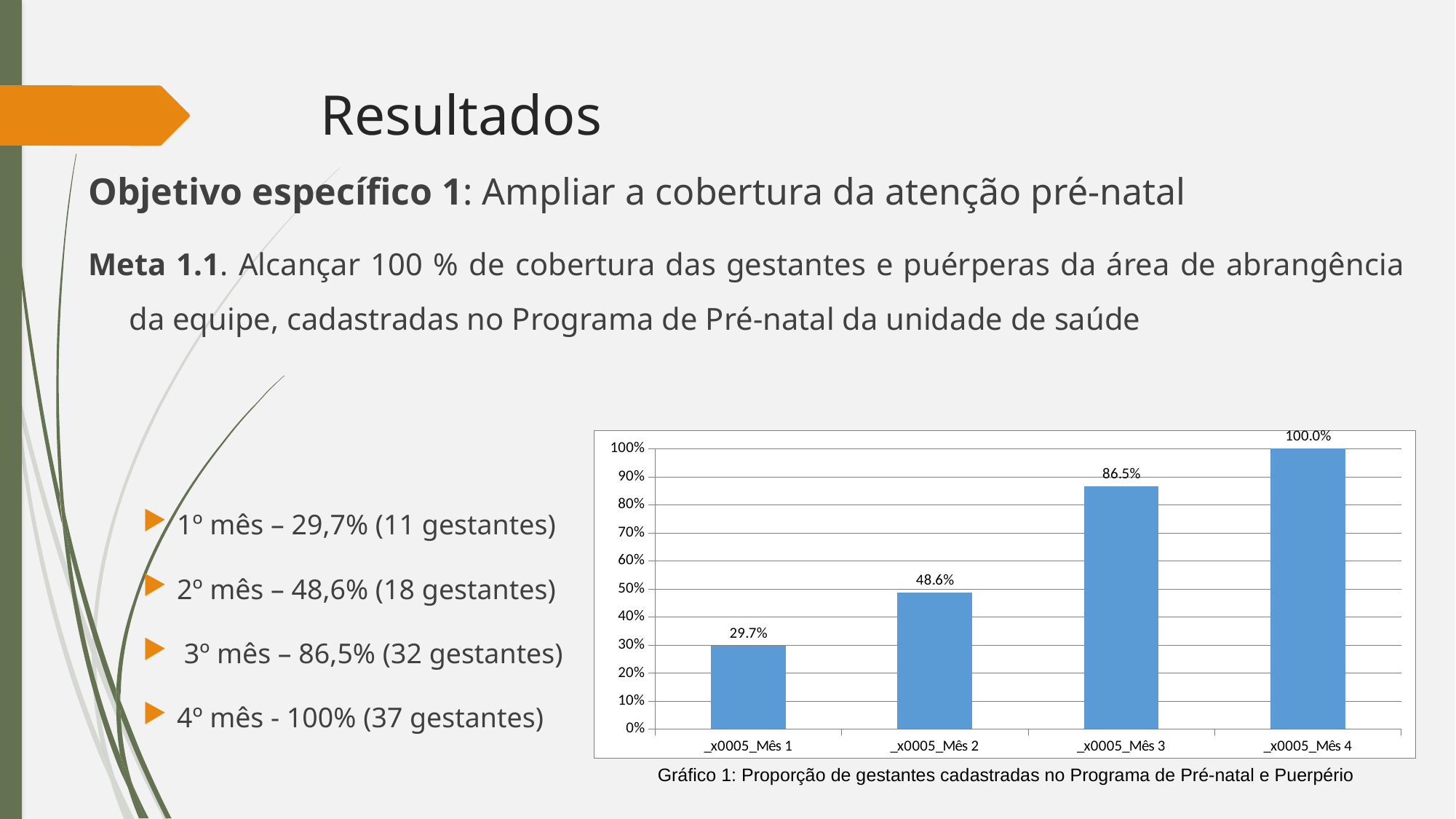
Do the values rise or fall from Mês 1 to Mês 4? Rise Which is larger, the value for Mês 2 or the value for Mês 3? Mês 3 Which month has the highest value in the chart? Mês 4 What is the value shown for Mês 4? 100.0% What is the value shown for Mês 1? 29.7% What is the caption/title of the chart? Gráfico 1: Proporção de gestantes cadastradas no Programa de Pré-natal e Puerpério What is the difference between the values for Mês 3 and Mês 2? 37.9% What kind of chart is shown on the slide? Bar chart Which month has the lowest value in the chart? Mês 1 How many categories (months) are plotted in the chart? 4 What is the value shown for Mês 2? 48.6% What is the value shown for Mês 3? 86.5%